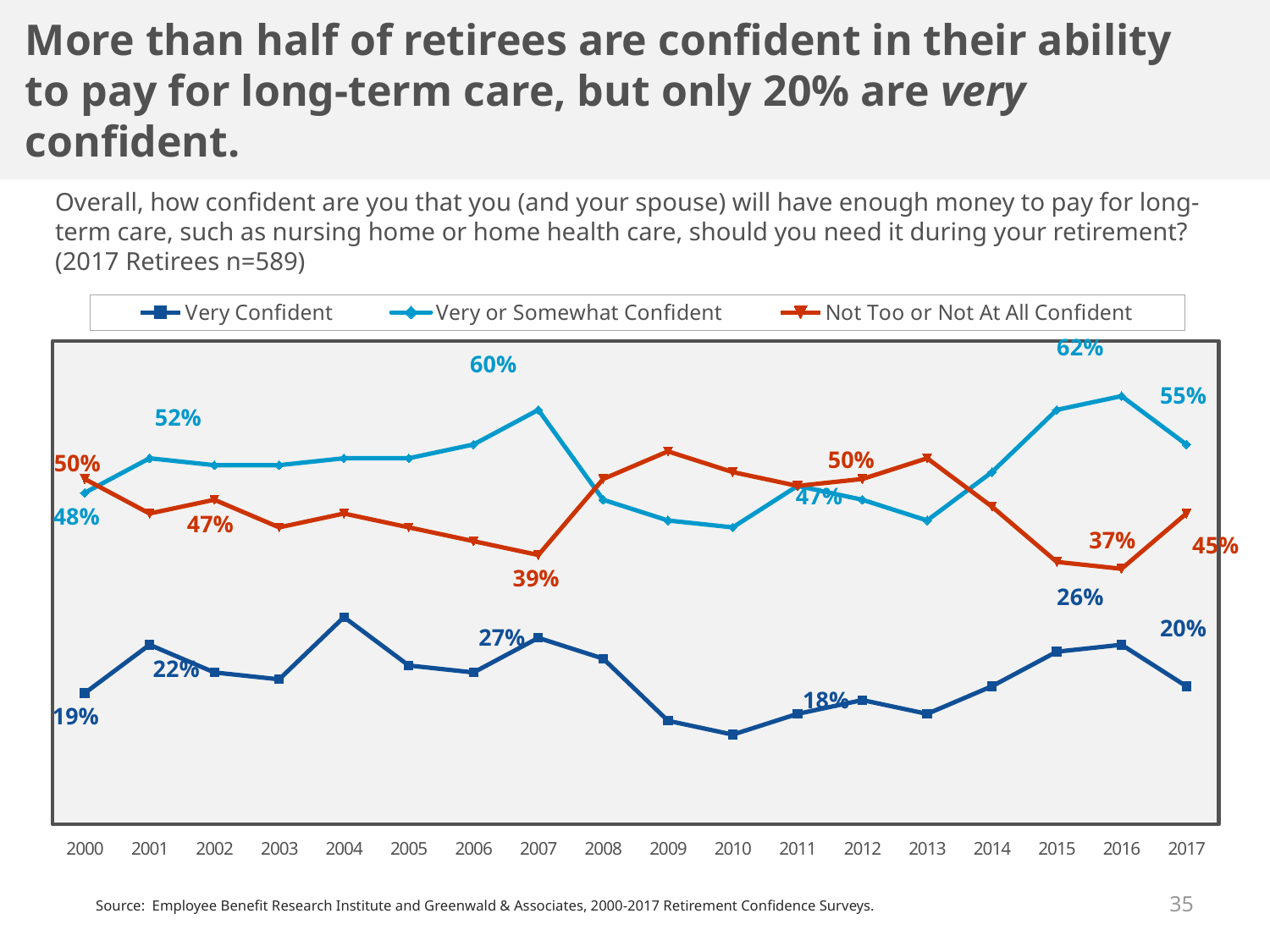
Does the Very Confident line rise or fall from 2016 to 2017? Fall How many years are shown on the x axis? 18 What is the value for Very Confident in 2000? 19% What type of chart is shown on the slide? Line chart Which series is shown in red in the legend? Not Too or Not At All Confident What is the value for Very Confident in 2017? 20% What is the value for Very or Somewhat Confident in 2007? 60% In 2007, which is larger: Very or Somewhat Confident or Not Too or Not At All Confident? Very or Somewhat Confident What is the difference between Very or Somewhat Confident and Very Confident in 2017? 35 percentage points How many series does the legend list? 3 What is the value for Not Too or Not At All Confident in 2016? 37% What is the value for Very or Somewhat Confident in 2017? 55%